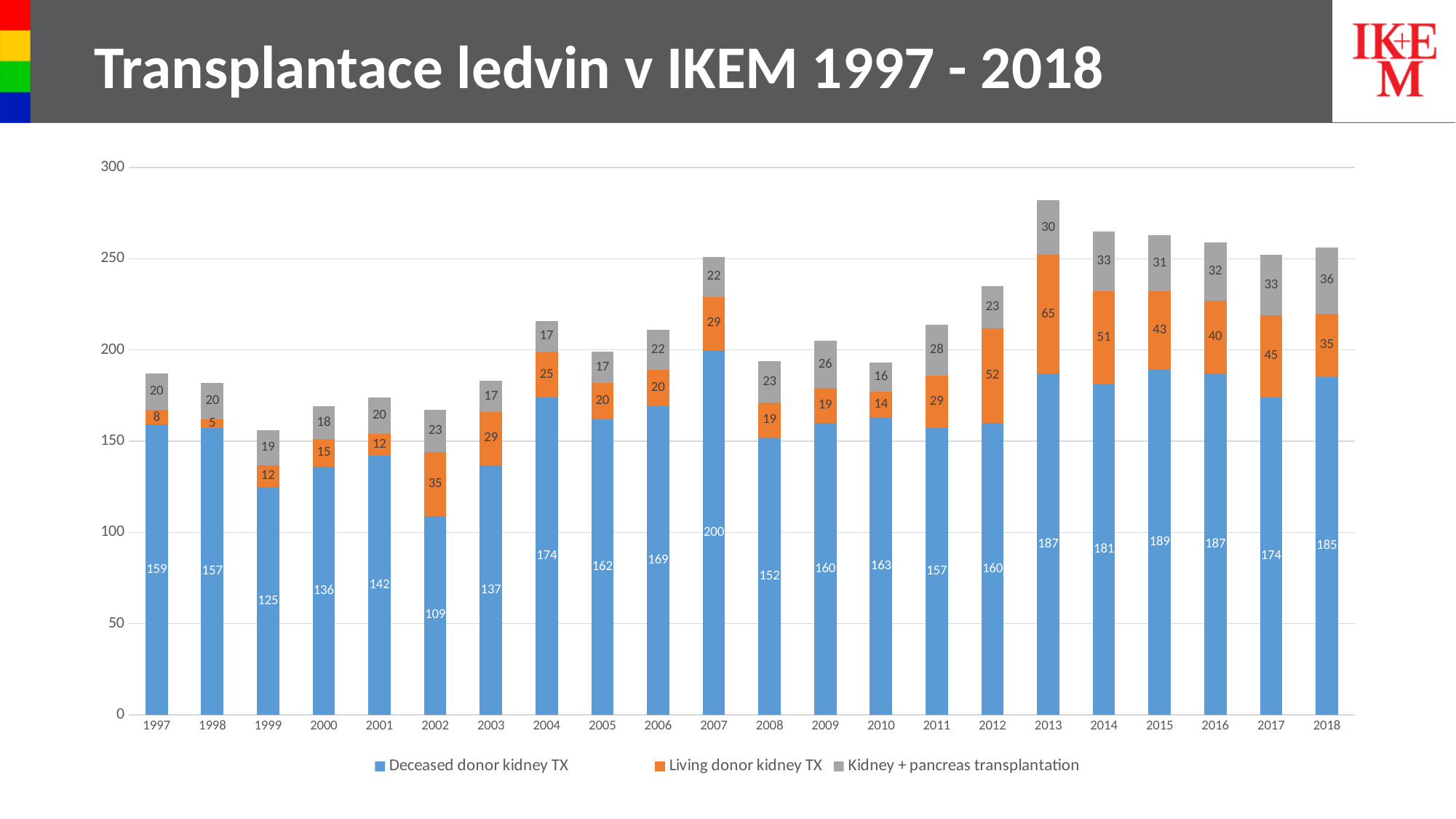
What is the total of the stacked bar for 2013? 282 Which year has the lowest value for Living donor kidney TX? 1998 What is the value for Deceased donor kidney TX in 2007? 200 How many series does the legend list? 3 What kind of chart is shown on the slide? Stacked bar chart Which year has the lowest value for Deceased donor kidney TX? 2002 What is the value for Kidney + pancreas transplantation in 2018? 36 How many years are shown on the x axis? 22 What is the value for Living donor kidney TX in 2013? 65 Which is larger, the Deceased donor kidney TX value for 2015 or for 2014? 2015 What is the difference between the Living donor kidney TX values for 2013 and 2012? 13 Which year has the highest value for Kidney + pancreas transplantation? 2018